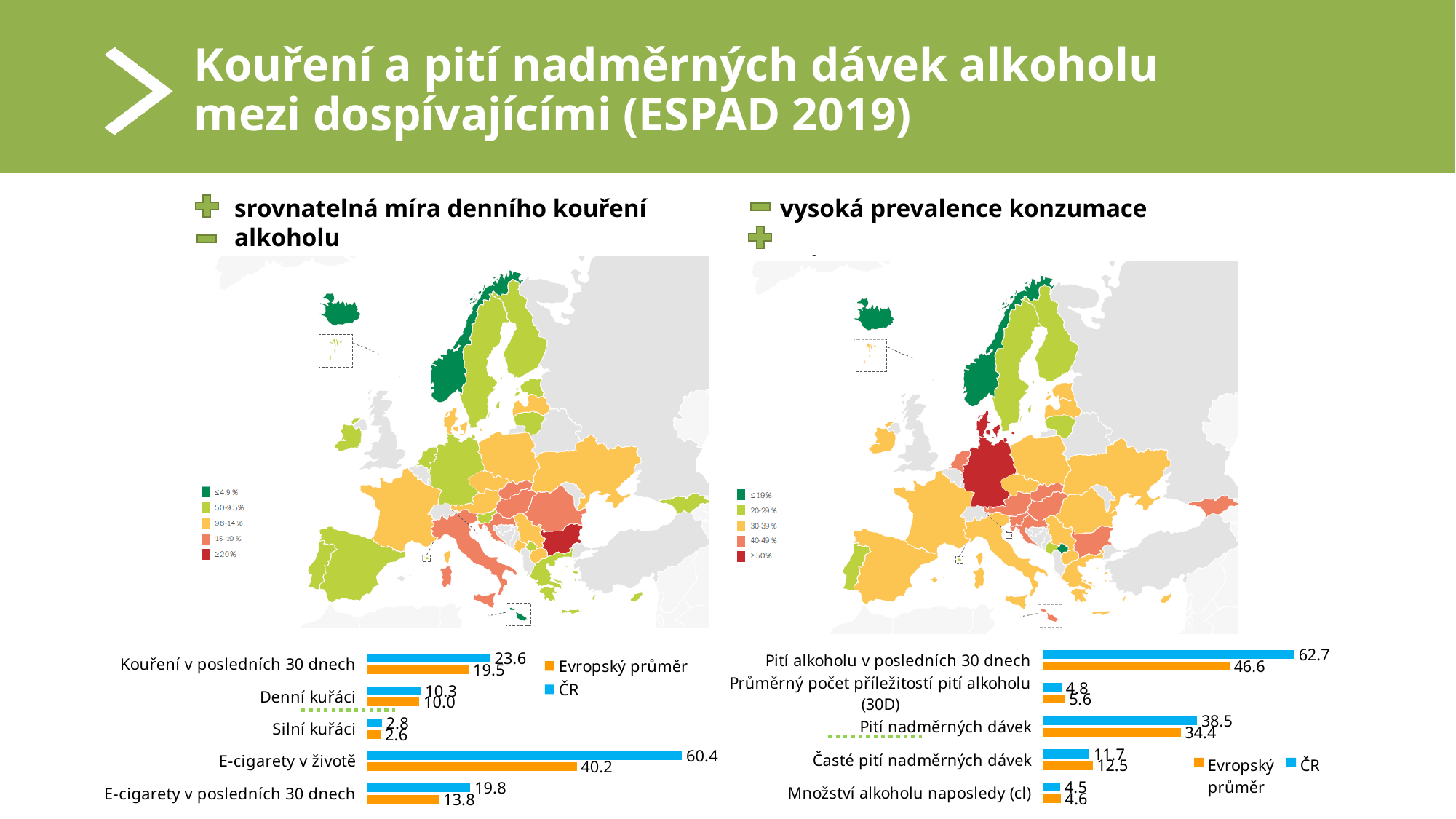
In the left bar chart, which category has the lowest Evropský průměr value? Silní kuřáci In the right bar chart, what is the difference between the ČR and Evropský průměr values for Pití alkoholu v posledních 30 dnech? 16.1 What type of chart is the left chart below the map? Bar chart In the right bar chart, which is larger for Časté pití nadměrných dávek: ČR or Evropský průměr? Evropský průměr In the left bar chart, what is the difference between the ČR and Evropský průměr values for E-cigarety v životě? 20.2 In the right bar chart, what is the Evropský průměr value for Pití nadměrných dávek? 34.4 In the left bar chart, how many categories are shown? 5 In the right bar chart, what is the ČR value for Pití alkoholu v posledních 30 dnech? 62.7 In the left bar chart, what is the ČR value for E-cigarety v životě? 60.4 In the left bar chart, what is the Evropský průměr value for Kouření v posledních 30 dnech? 19.5 How many series does the legend of the right bar chart list? 2 In the left bar chart, which category has the highest ČR value? E-cigarety v životě